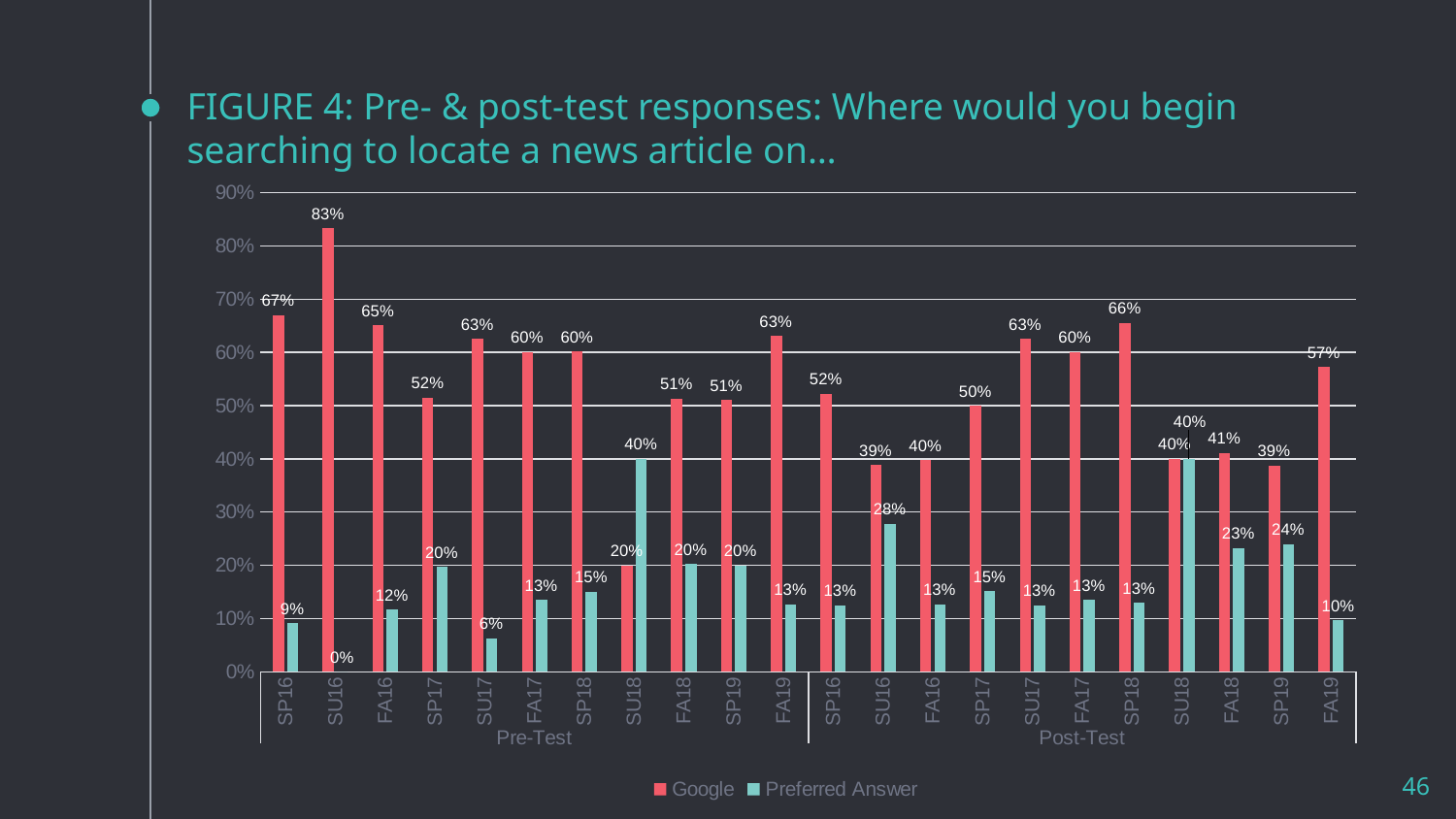
What kind of chart is shown on the slide? Bar chart Which category has the lowest Preferred Answer value across the whole chart? SU16 (Pre-Test) Which category has the highest Google value across the whole chart? SU16 (Pre-Test) In the Pre-Test group, which is larger for SU18: the Google value or the Preferred Answer value? Preferred Answer What is the Preferred Answer value for SU18 in the Post-Test group? 40% How many series does the legend list? 2 What colour represents the Google series in the chart? Red What is the difference between the Google value for SU18 in the Pre-Test group and the Google value for SU18 in the Post-Test group? 20% What is the Google value for SP18 in the Post-Test group? 66% Is the Google value for FA19 in the Post-Test group greater or less than 50%? greater What is the Google value for SU16 in the Pre-Test group? 83% What is the difference between the Google and Preferred Answer values for SU16 in the Pre-Test group? 83%